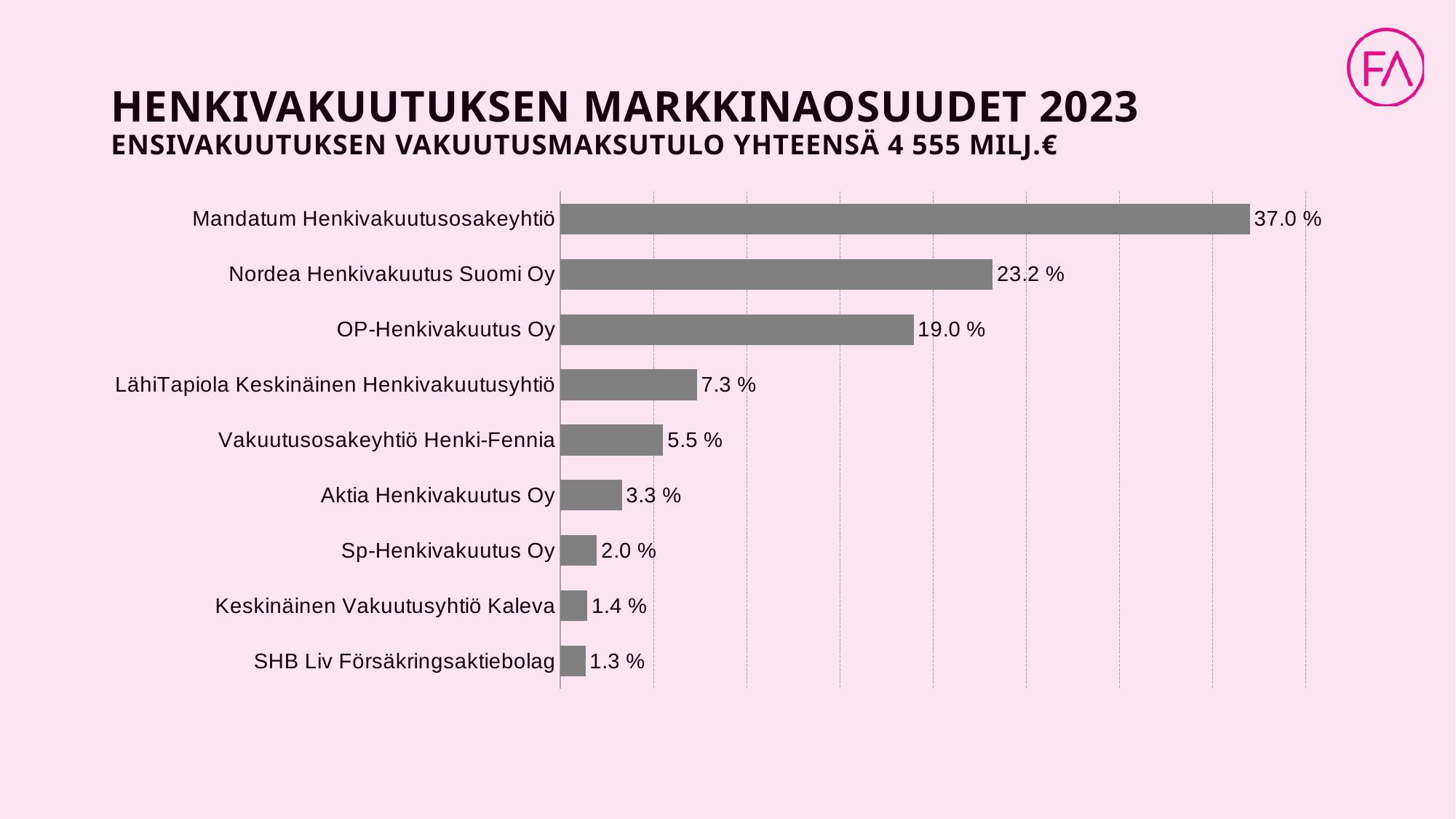
What is the market share shown for OP-Henkivakuutus Oy? 19.0 % How many companies are shown on the chart? 9 What is the market share shown for Vakuutusosakeyhtiö Henki-Fennia? 5.5 % What is the title of the chart on the slide? HENKIVAKUUTUKSEN MARKKINAOSUUDET 2023 Which company has the highest market share on the chart? Mandatum Henkivakuutusosakeyhtiö What is the difference in market share between Mandatum Henkivakuutusosakeyhtiö and Nordea Henkivakuutus Suomi Oy? 13.8 % What kind of chart is shown on the slide? Bar chart Which company has the lowest market share on the chart? SHB Liv Försäkringsaktiebolag What is the difference in market share between Nordea Henkivakuutus Suomi Oy and OP-Henkivakuutus Oy? 4.2 % What is the market share shown for Keskinäinen Vakuutusyhtiö Kaleva? 1.4 % What is the market share shown for Mandatum Henkivakuutusosakeyhtiö? 37.0 % Which has a larger market share, LähiTapiola Keskinäinen Henkivakuutusyhtiö or Aktia Henkivakuutus Oy? LähiTapiola Keskinäinen Henkivakuutusyhtiö